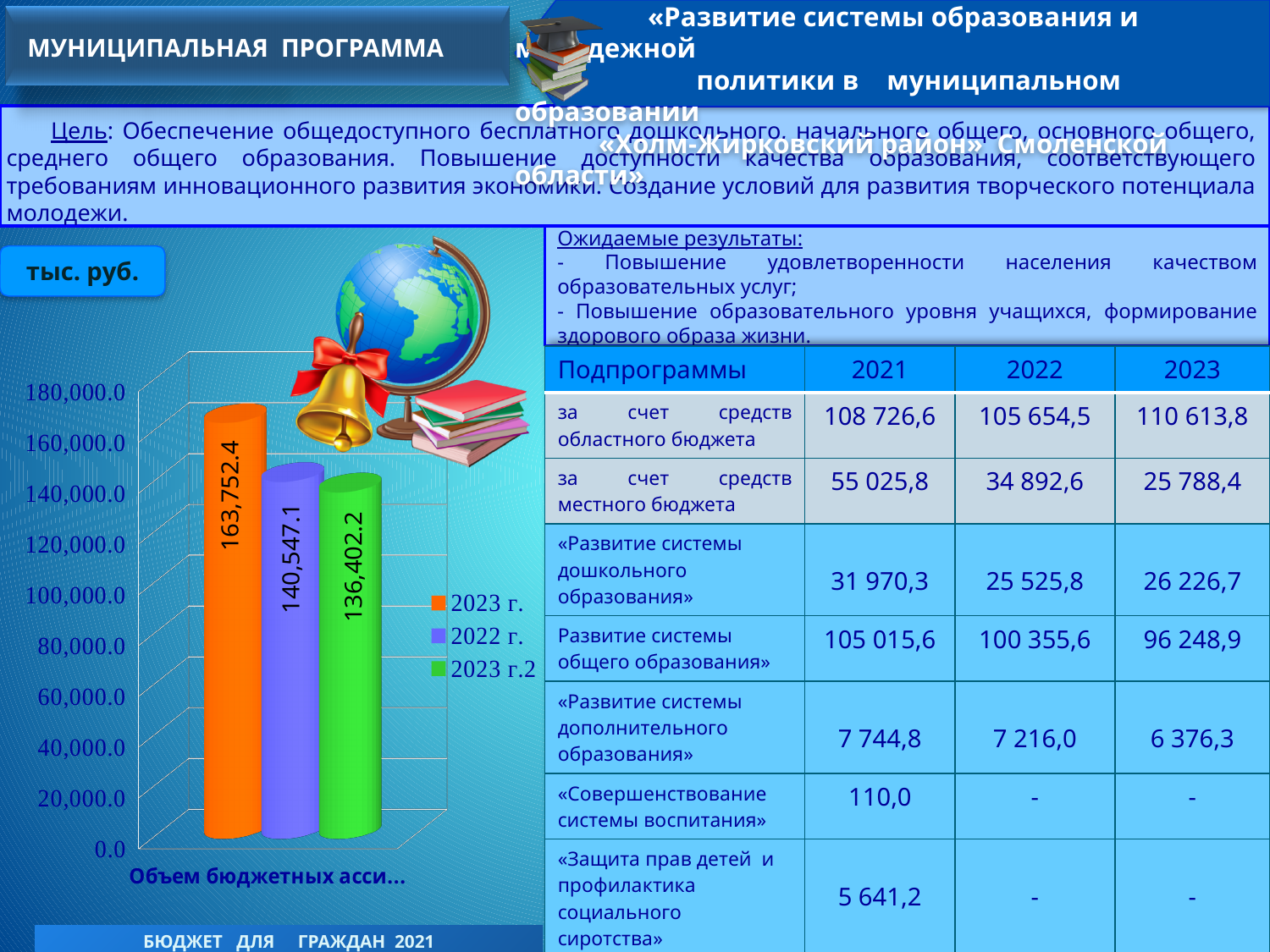
What is the difference between the "2023 г." bar and the "2022 г." bar? 23,205.3 What kind of chart is shown on the slide? bar chart What unit is shown in the label box next to the chart? тыс. руб. Which legend series has the highest value in the chart? 2023 г. How many series does the chart legend list? 3 What is the value of the blue bar labelled "2022 г." in the chart? 140,547.1 What is the value of the orange bar labelled "2023 г." in the chart? 163,752.4 Is the value of the "2023 г." bar greater or less than 160,000.0? greater What is the difference between the "2022 г." bar and the "2023 г.2" bar? 4,144.9 What is the value of the green bar labelled "2023 г.2" in the chart? 136,402.2 Which is larger, the "2023 г." bar or the "2023 г.2" bar? 2023 г. Which legend series has the lowest value in the chart? 2023 г.2